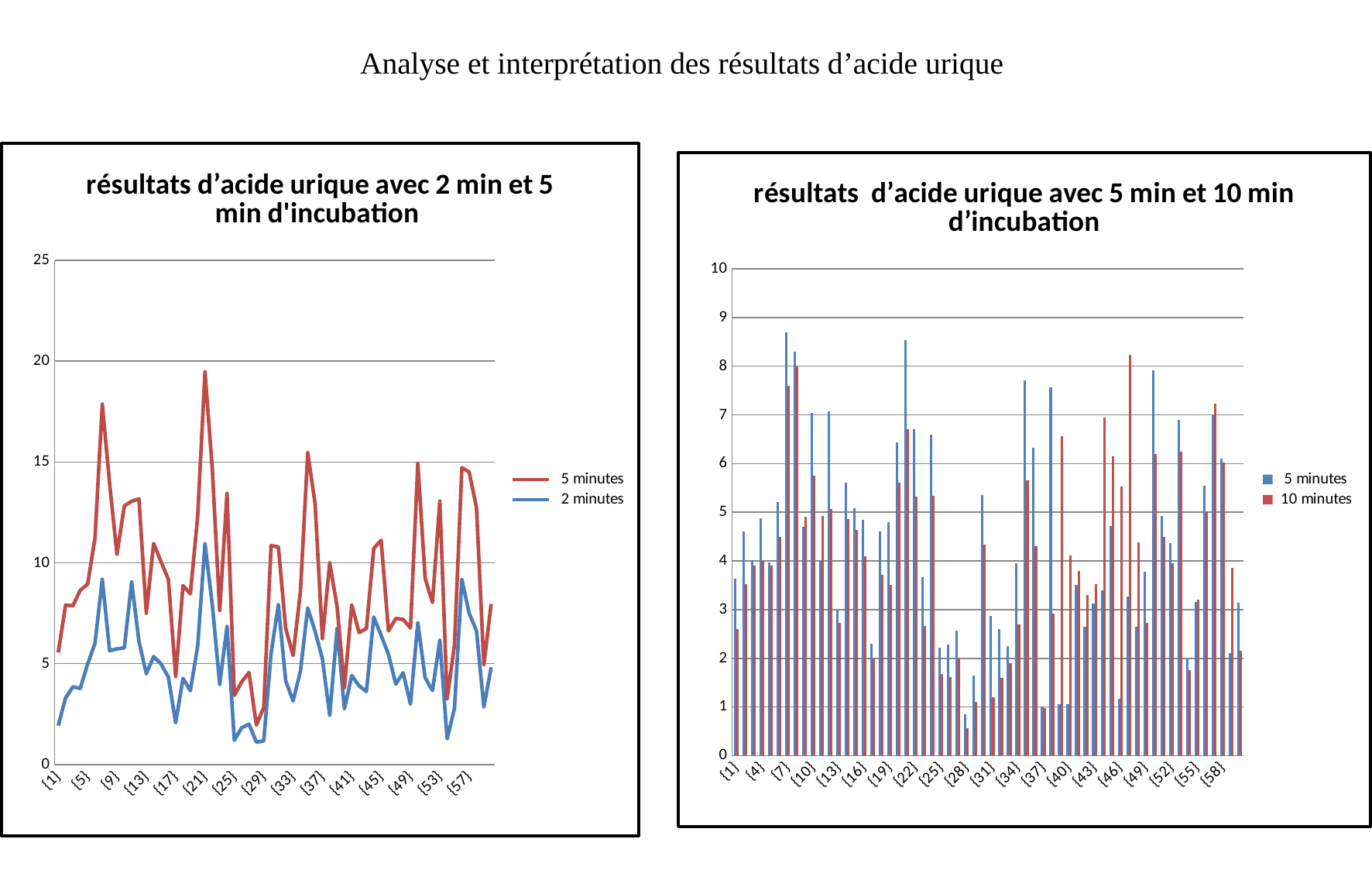
In the left chart, is the 2 minutes value at {1} greater or less than 5? less What kind of chart is the right chart, 'résultats d'acide urique avec 5 min et 10 min d'incubation'? bar chart How many series does the legend of the left chart list? 2 In the left chart, which series is drawn in red? 5 minutes In the right chart, is the 5 minutes value at {7} greater or less than 8? greater In the right chart, is the 10 minutes value at {28} greater or less than 1? less What kind of chart is the left chart, 'résultats d'acide urique avec 2 min et 5 min d'incubation'? line chart Which two series are listed in the legend of the right chart? 5 minutes and 10 minutes In the right chart, at which x-axis label does the 5 minutes series reach its highest value? {7}